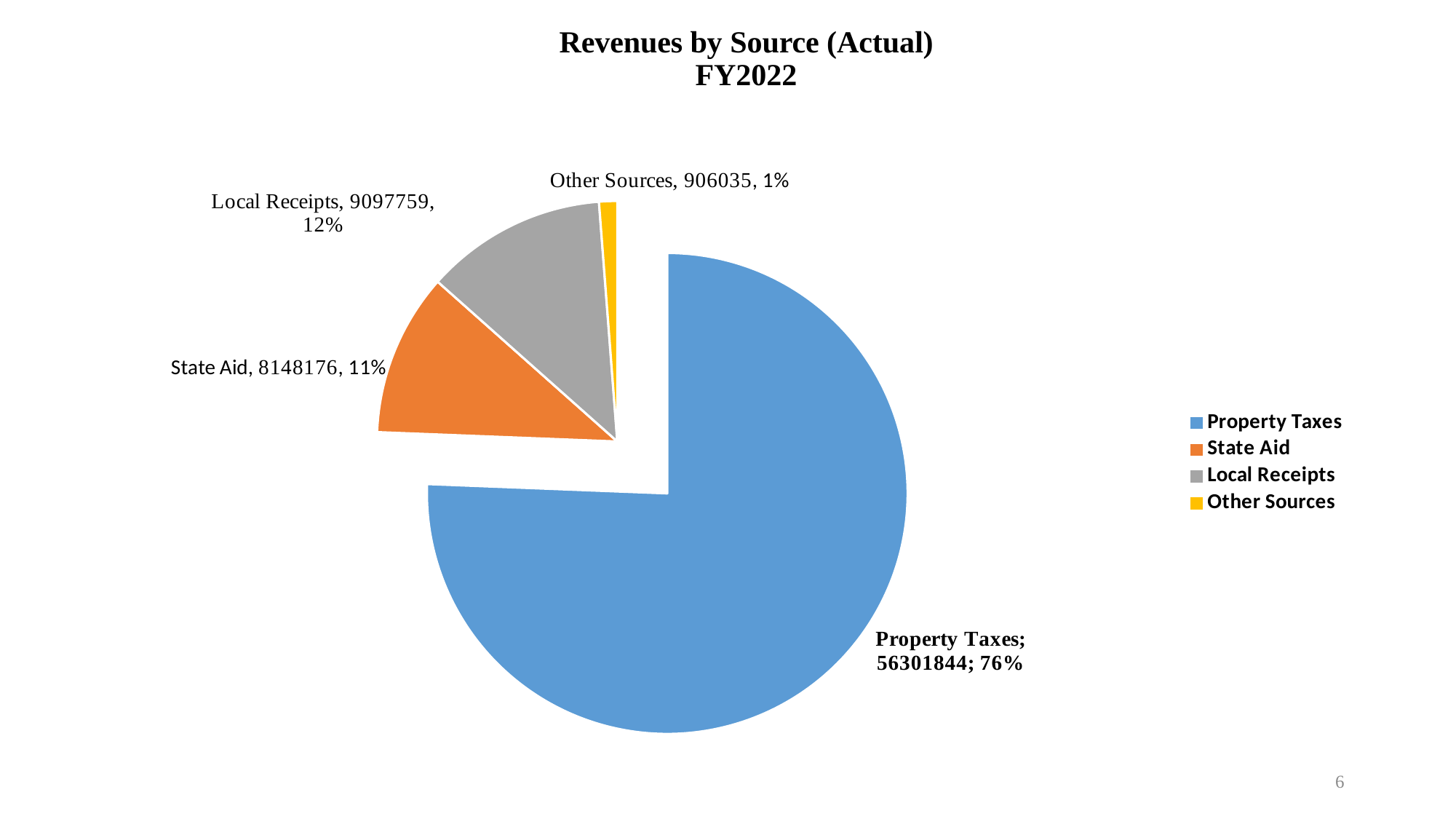
Which revenue source is the smallest? Other Sources Which revenue source is the largest? Property Taxes What is the difference between the values for Local Receipts and State Aid? 949583 What share of the pie does Property Taxes represent? 76% What is the value for Local Receipts? 9097759 What share of the pie does Local Receipts represent? 12% How many slices does the pie chart have? 4 What kind of chart is shown on the slide? Pie chart What is the value for State Aid? 8148176 What is the value for Property Taxes? 56301844 Which is larger, State Aid or Local Receipts? Local Receipts What is the value for Other Sources? 906035